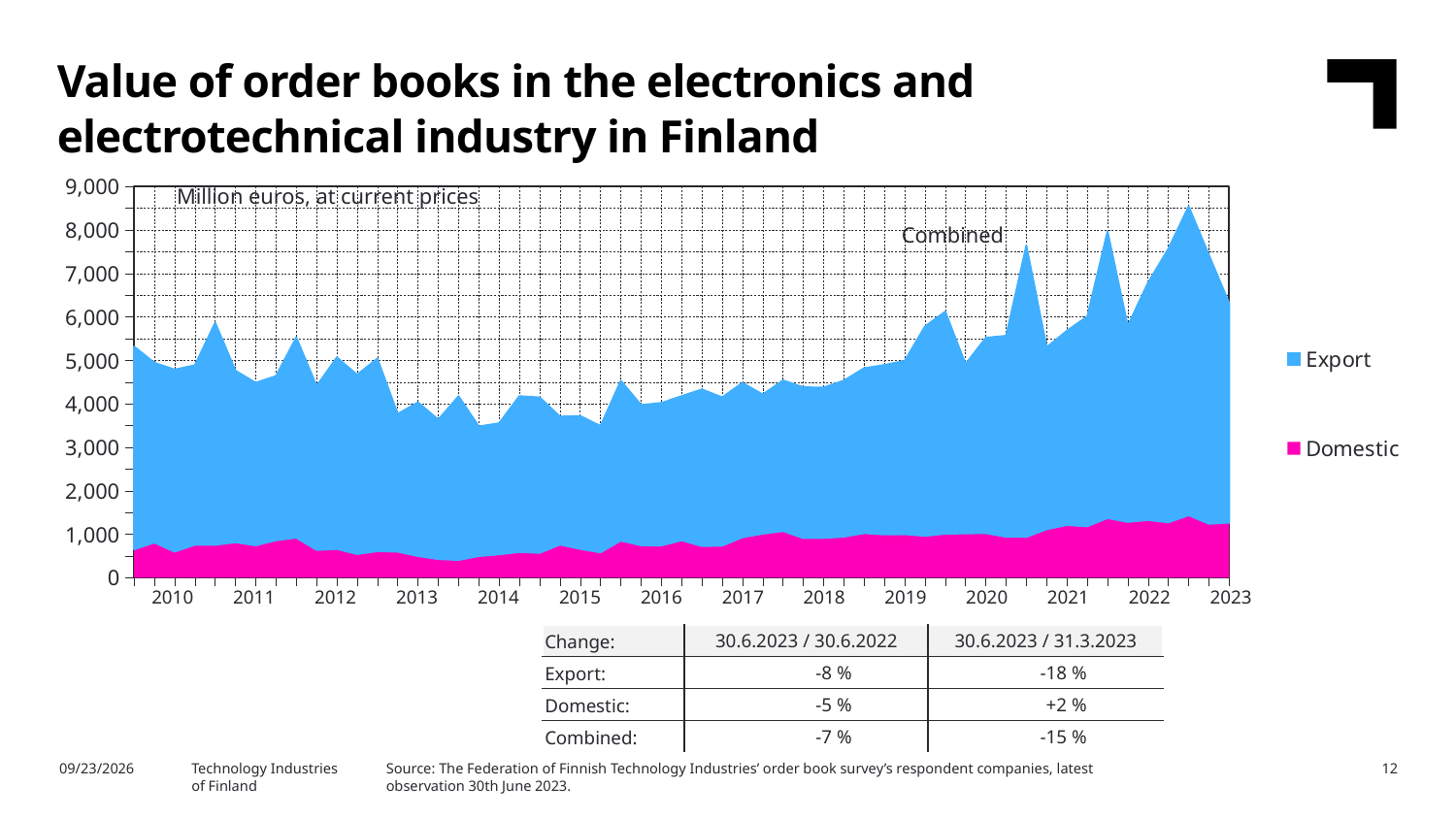
Which series, Export or Domestic, has the larger value in 2023? Export Does the Domestic series generally rise or fall between 2010 and 2023? rise Does the combined value of order books generally rise or fall between 2016 and 2022? rise Is the combined value of order books in 2013 greater or less than 5,000? less How many series does the chart legend list? 2 What unit is stated for the values in the chart? Million euros, at current prices Is the Domestic value of order books in 2023 greater or less than 1,000? greater What are the two series named in the chart legend? Export and Domestic Is the combined value of order books at its 2022 peak greater or less than 8,000? greater What kind of chart is shown on the slide? Area chart